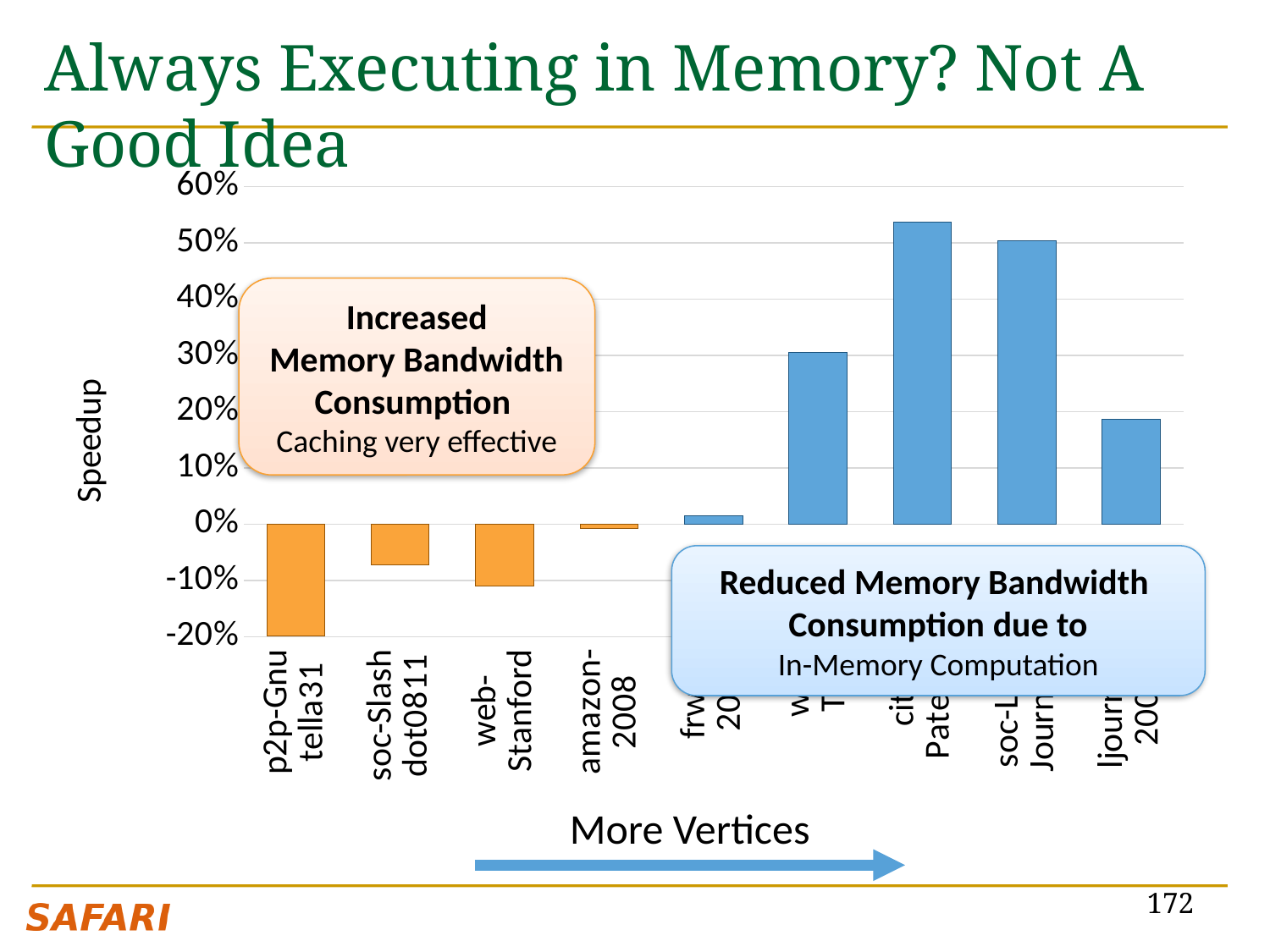
What kind of chart is shown on the slide? bar chart How many bars (categories) are plotted in the chart? 9 Is the speedup for amazon-2008 greater or less than 0%? less Is the speedup for soc-Slashdot0811 greater or less than -10%? greater Which has the lower speedup, web-Stanford or soc-Slashdot0811? web-Stanford Which category has the lowest speedup in the chart? p2p-Gnutella31 What is the label of the vertical axis of the chart? Speedup Is the tallest bar in the chart greater or less than 50%? greater What text is written above the arrow beneath the x axis? More Vertices Do the speedup values generally rise or fall moving left to right along the x axis? rise